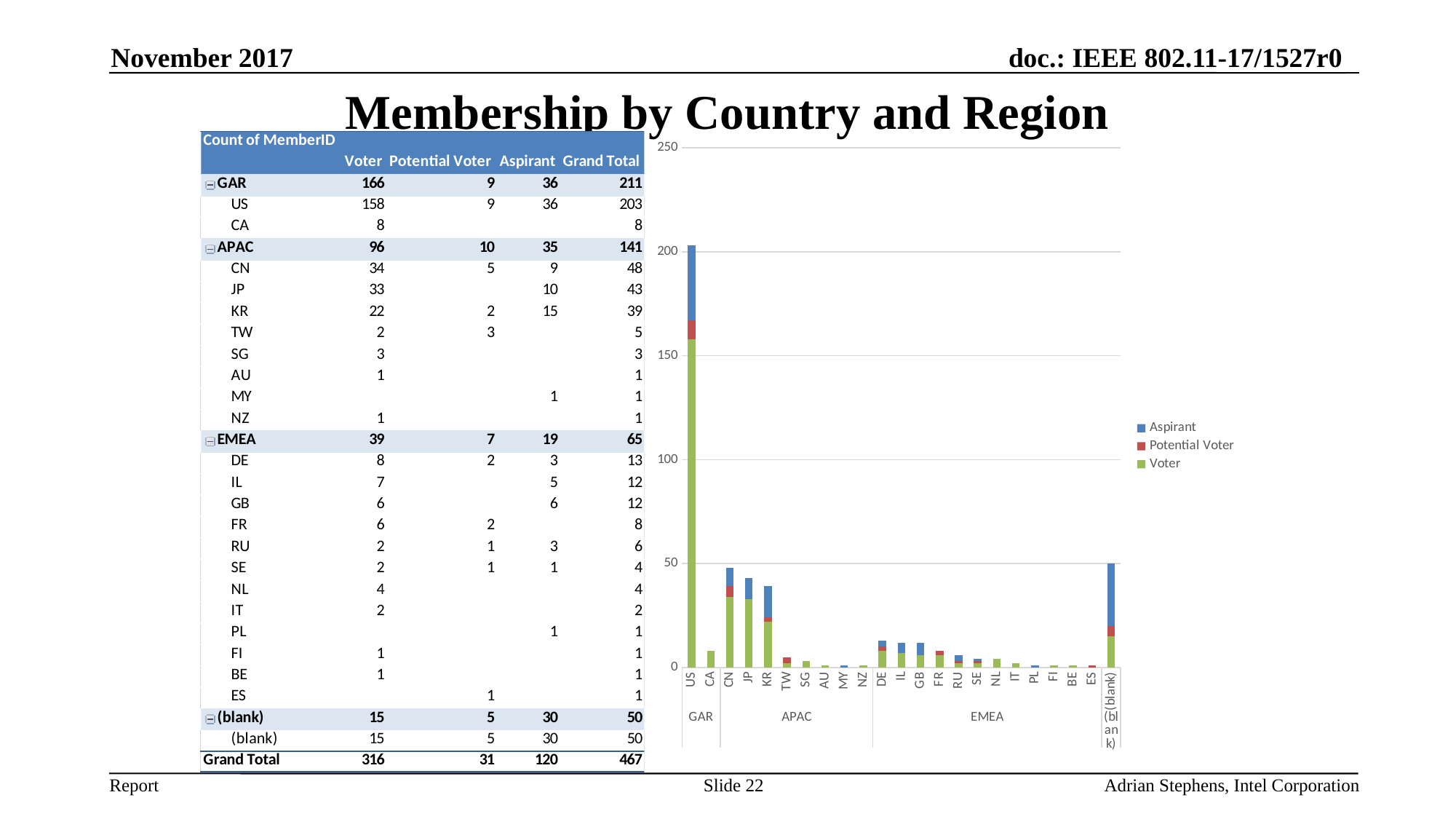
Which country has the tallest bar in the chart? US Which bar is taller, CN or JP? CN What are the three series named in the chart legend? Aspirant, Potential Voter, Voter According to the table, what is the difference between the Grand Total for US and the Grand Total for CN? 155 Is the total bar height for CN greater or less than 50? less How many series does the chart legend list? 3 Is the total bar height for US greater or less than 200? greater What kind of chart is shown on the slide? bar chart According to the table, what is the Voter count for US? 158 According to the table, what is the Grand Total for APAC? 141 Is the total bar height for KR greater or less than 50? less How many region groups are labelled along the x axis of the chart? 4